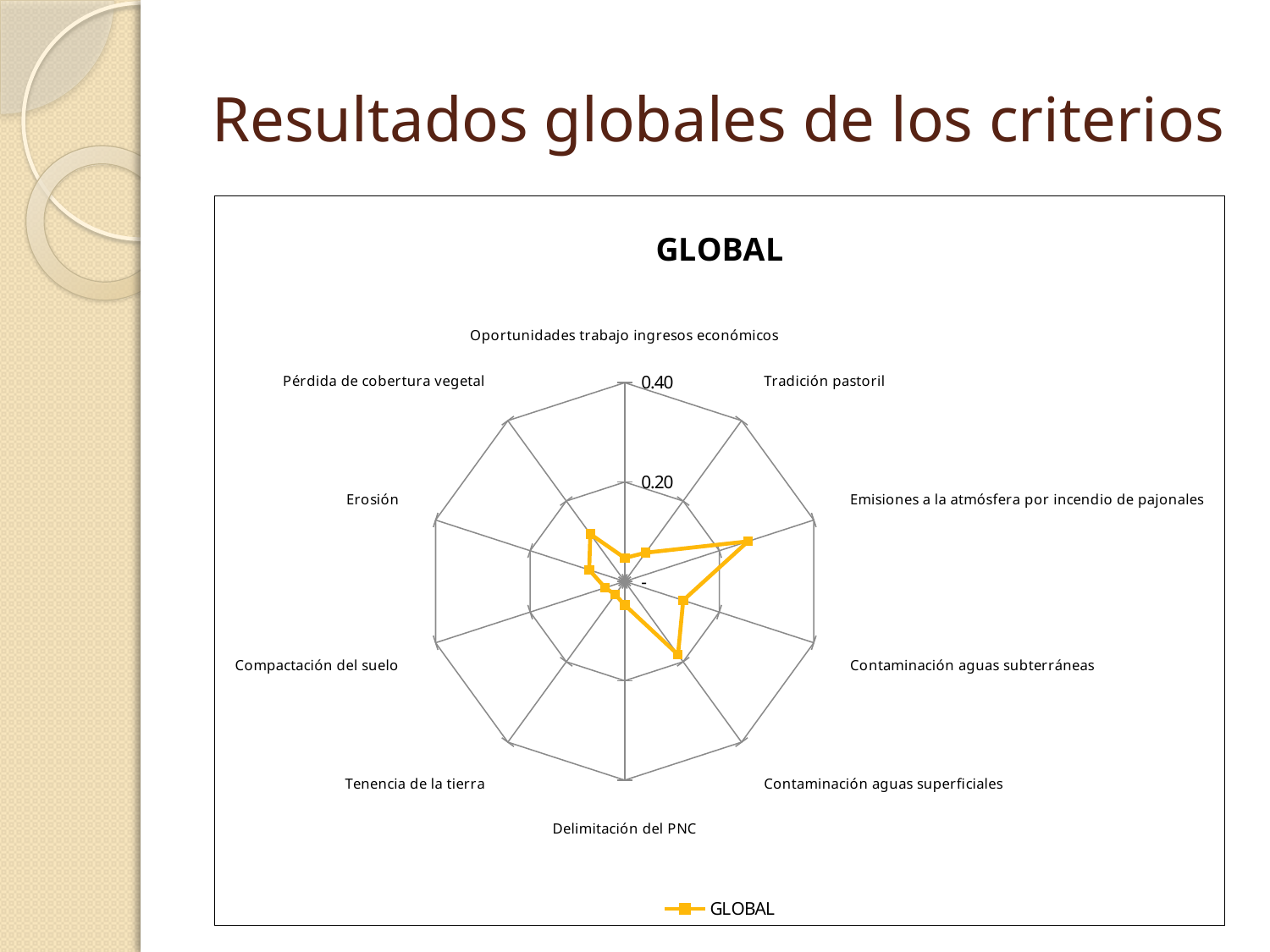
How many series does the legend list? 1 Which is larger, the value for Contaminación aguas superficiales or the value for Tradición pastoril? Contaminación aguas superficiales What kind of chart is shown on the slide? Radar chart Is the value for Emisiones a la atmósfera por incendio de pajonales greater or less than 0.40? less What is the title of the chart? GLOBAL Is the value for Compactación del suelo greater or less than 0.20? less Is the value for Emisiones a la atmósfera por incendio de pajonales greater or less than 0.20? greater How many categories (axes) does the radar chart have? 10 Which is larger, the value for Emisiones a la atmósfera por incendio de pajonales or the value for Contaminación aguas superficiales? Emisiones a la atmósfera por incendio de pajonales What is the name of the series shown in the legend? GLOBAL Which category has the highest value? Emisiones a la atmósfera por incendio de pajonales